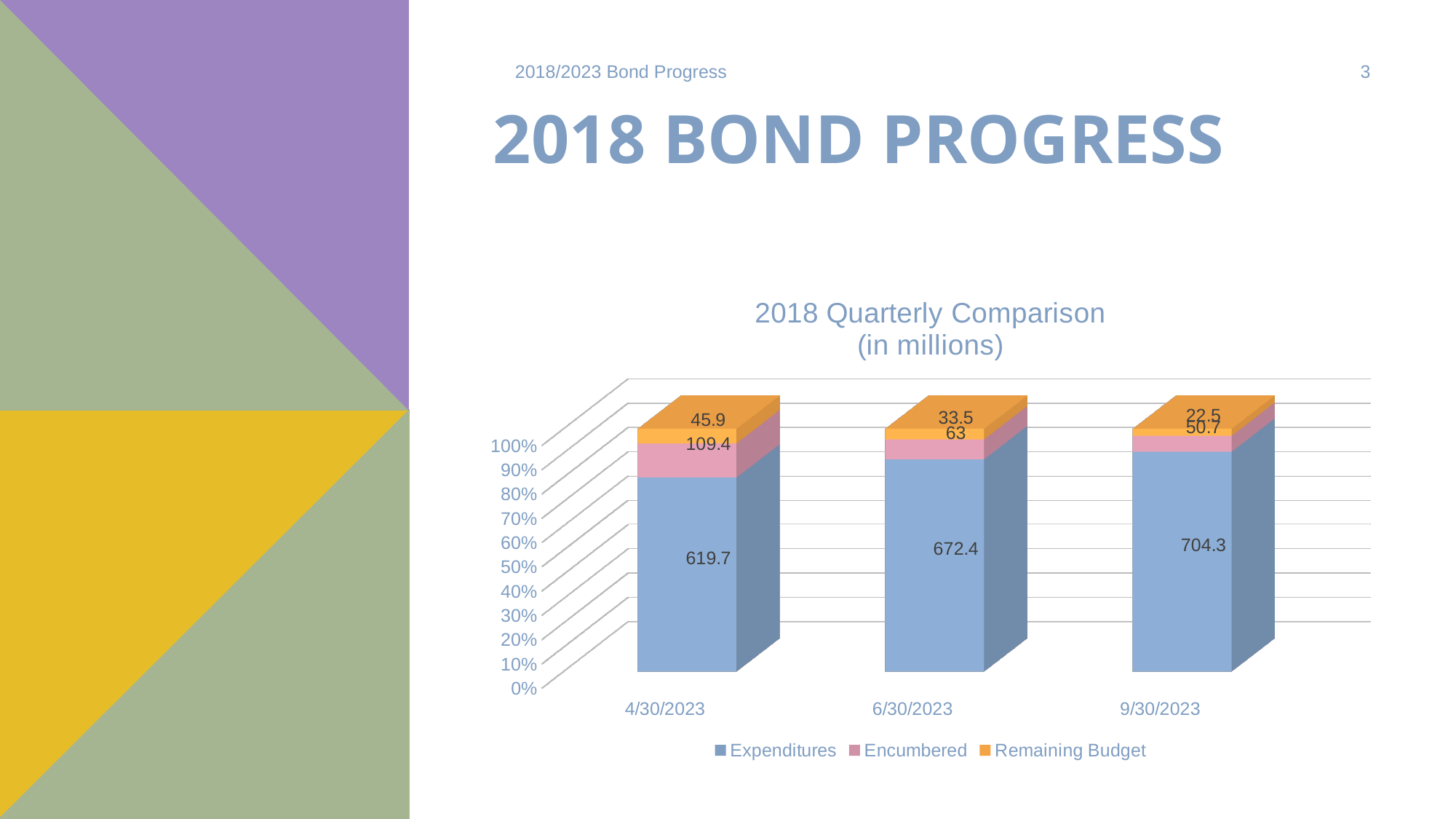
How many series does the legend list? 3 Do the Remaining Budget values rise or fall from 4/30/2023 to 9/30/2023? Fall How many dates are shown on the x axis? 3 Which is larger, the Encumbered value for 4/30/2023 or for 9/30/2023? 4/30/2023 Which date has the highest Expenditures value? 9/30/2023 What is the difference between the Expenditures values for 9/30/2023 and 4/30/2023? 84.6 What is the Remaining Budget value for 9/30/2023? 22.5 What is the Encumbered value for 6/30/2023? 63 What is the Expenditures value for 4/30/2023? 619.7 What kind of chart is shown on the slide? Stacked bar chart What is the total of the three values in the 6/30/2023 bar? 768.9 Which date has the lowest Remaining Budget value? 9/30/2023